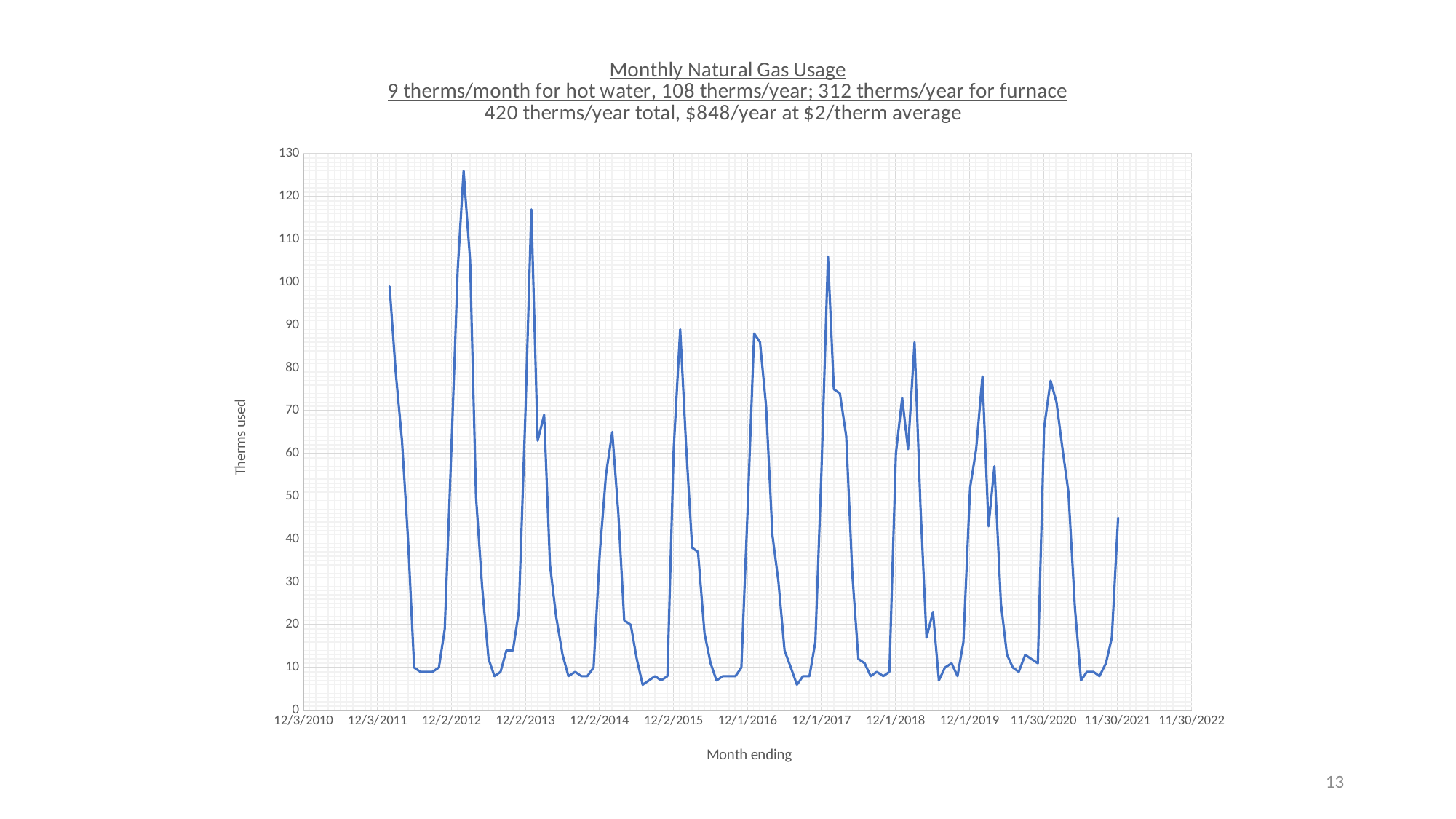
Is the peak near 12/2/2013 greater or less than 110 therms? greater Overall, do the winter peaks tend to rise or fall from 12/2/2012 to 11/30/2020? fall What is the label on the vertical axis? Therms used Is the peak near 12/1/2017 greater or less than 100 therms? greater What is the first line of the chart title? Monthly Natural Gas Usage What kind of chart is shown on the slide? line chart Which is higher: the peak near 12/2/2014 or the peak near 12/2/2015? the peak near 12/2/2015 Near which x-axis date does the line reach its highest peak? 12/2/2012 Is the peak near 12/2/2014 greater or less than 70 therms? less Which is higher: the peak near 12/2/2012 or the peak near 12/2/2013? the peak near 12/2/2012